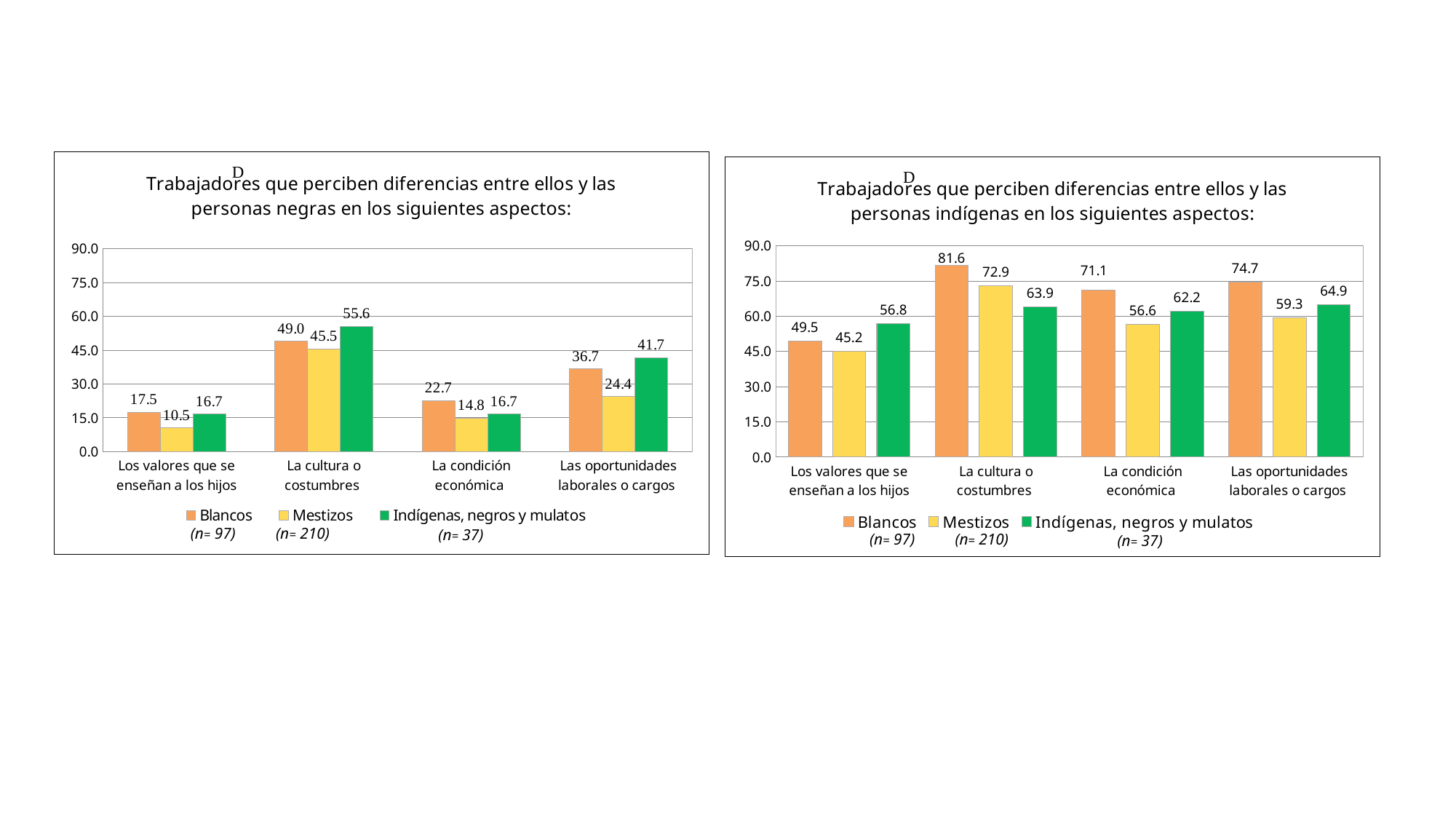
In the right chart (personas indígenas), which category has the highest value for Blancos? La cultura o costumbres In the right chart (personas indígenas), which is larger in 'Los valores que se enseñan a los hijos': Blancos or Indígenas, negros y mulatos? Indígenas, negros y mulatos In the left chart (personas negras), what is the value for Blancos in 'La cultura o costumbres'? 49.0 How many series does the legend of the right chart (personas indígenas) list? 3 In the left chart (personas negras), what sample size (n) is shown for Mestizos in the legend? n= 210 What kind of chart is the left chart (personas negras)? Bar chart In the right chart (personas indígenas), what is the value for Mestizos in 'La condición económica'? 56.6 In the left chart (personas negras), which category has the lowest value for Mestizos? Los valores que se enseñan a los hijos In the left chart (personas negras), what is the difference between the Indígenas, negros y mulatos value and the Mestizos value in 'Las oportunidades laborales o cargos'? 17.3 In the right chart (personas indígenas), is the value for Blancos in 'La condición económica' greater or less than 60.0? greater How many categories are shown on the x axis of the left chart (personas negras)? 4 In the right chart (personas indígenas), what is the difference between the Blancos value and the Mestizos value in 'La cultura o costumbres'? 8.7